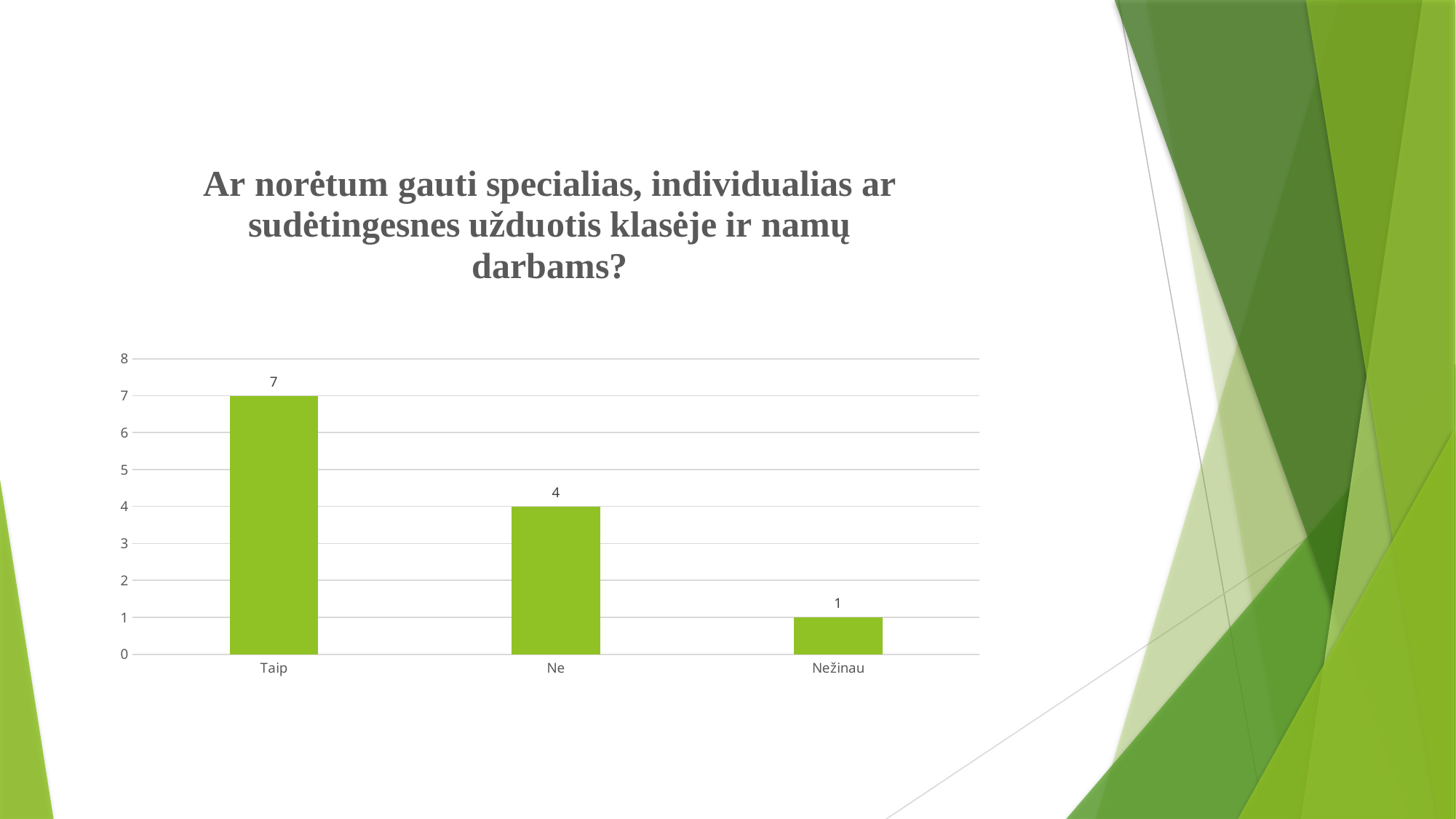
What is the value for Taip? 7 What kind of chart is shown on the slide? bar chart Which is larger, the value for Ne or the value for Nežinau? Ne What is the value for Nežinau? 1 Which category has the highest value? Taip What is the difference between the values for Ne and Nežinau? 3 Is the value for Taip greater or less than 5? greater How many categories are shown on the x axis? 3 What is the difference between the values for Taip and Ne? 3 Do the values rise or fall from left to right along the x axis? fall What is the value for Ne? 4 Which category has the lowest value? Nežinau